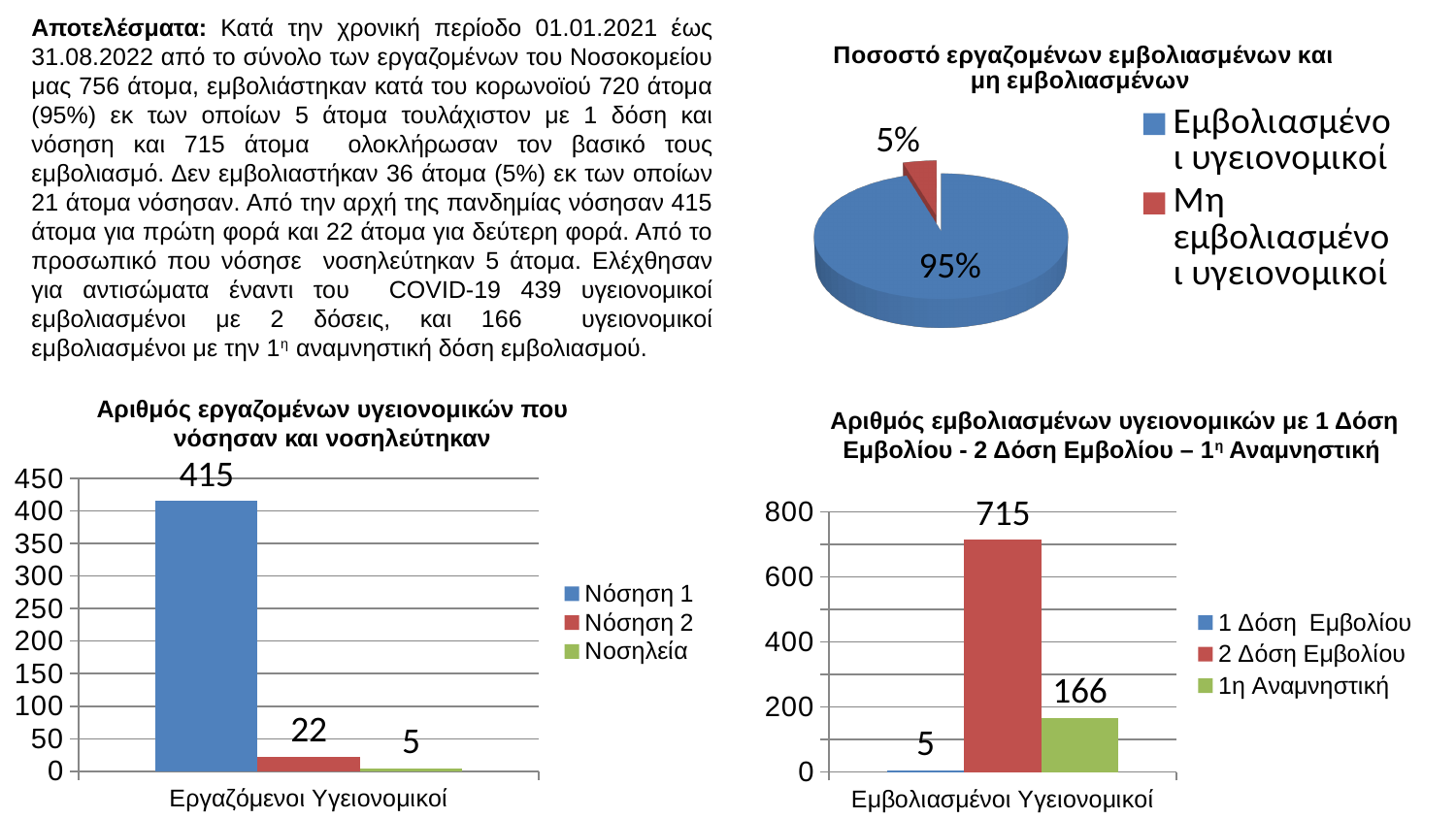
In the bottom-left chart 'Αριθμός εργαζομένων υγειονομικών που νόσησαν και νοσηλεύτηκαν', which series has the lowest value? Νοσηλεία In the pie chart 'Ποσοστό εργαζομένων εμβολιασμένων και μη εμβολιασμένων', what share is shown for 'Μη εμβολιασμένοι υγειονομικοί'? 5% In the bottom-left chart 'Αριθμός εργαζομένων υγειονομικών που νόσησαν και νοσηλεύτηκαν', what is the difference between 'Νόσηση 1' and 'Νόσηση 2'? 393 In the bottom-right chart 'Αριθμός εμβολιασμένων υγειονομικών με 1 Δόση Εμβολίου - 2 Δόση Εμβολίου – 1η Αναμνηστική', what is the value for '2 Δόση Εμβολίου'? 715 In the pie chart 'Ποσοστό εργαζομένων εμβολιασμένων και μη εμβολιασμένων', what share is shown for 'Εμβολιασμένοι υγειονομικοί'? 95% In the bottom-right chart 'Αριθμός εμβολιασμένων υγειονομικών με 1 Δόση Εμβολίου - 2 Δόση Εμβολίου – 1η Αναμνηστική', which series has the highest value? 2 Δόση Εμβολίου In the bottom-right chart 'Αριθμός εμβολιασμένων υγειονομικών με 1 Δόση Εμβολίου - 2 Δόση Εμβολίου – 1η Αναμνηστική', which is larger: '1 Δόση Εμβολίου' or '1η Αναμνηστική'? 1η Αναμνηστική How many series does the legend of the bottom-left chart 'Αριθμός εργαζομένων υγειονομικών που νόσησαν και νοσηλεύτηκαν' list? 3 In the bottom-left chart 'Αριθμός εργαζομένων υγειονομικών που νόσησαν και νοσηλεύτηκαν', what is the value for 'Νόσηση 1'? 415 In the bottom-left chart 'Αριθμός εργαζομένων υγειονομικών που νόσησαν και νοσηλεύτηκαν', what is the value for 'Νόσηση 2'? 22 In the bottom-right chart 'Αριθμός εμβολιασμένων υγειονομικών με 1 Δόση Εμβολίου - 2 Δόση Εμβολίου – 1η Αναμνηστική', what is the value for '1η Αναμνηστική'? 166 What kind of chart is the top-right chart 'Ποσοστό εργαζομένων εμβολιασμένων και μη εμβολιασμένων'? Pie chart